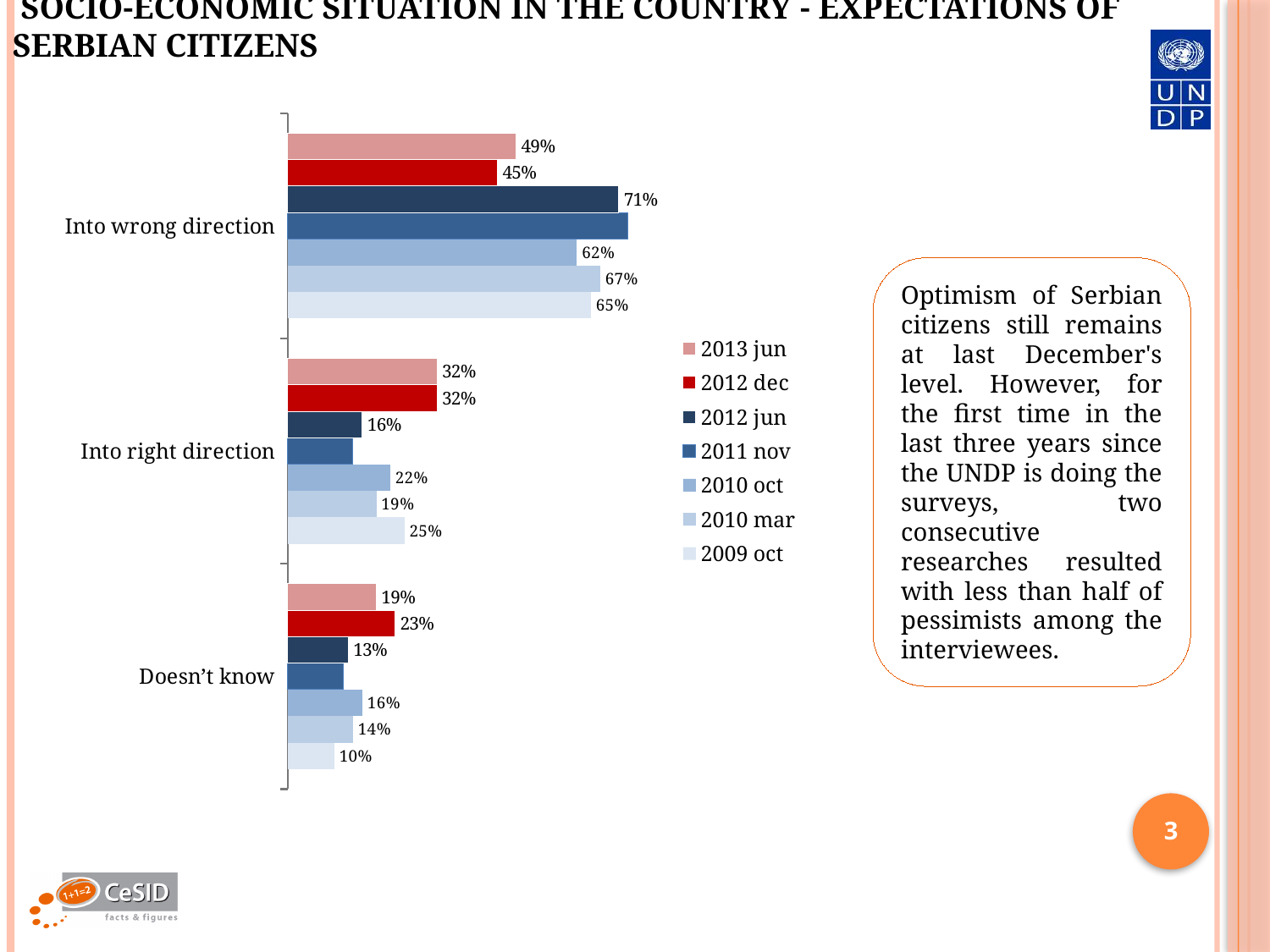
What is the value for 2009 oct in the 'Doesn't know' category? 10% In the 'Doesn't know' category, which is larger: the 2012 dec value or the 2013 jun value? 2012 dec What is the value for 2010 mar in the 'Into right direction' category? 19% How many series does the legend list? 7 In the 'Into right direction' category, which is larger: the 2010 oct value or the 2009 oct value? 2009 oct What is the value for 2013 jun in the 'Into wrong direction' category? 49% How many categories are shown on the chart? 3 Which survey wave has the lowest value in the 'Into wrong direction' category? 2012 dec What is the difference between the 2013 jun and 2012 dec values in the 'Into wrong direction' category? 4 percentage points What is the value for 2012 jun in the 'Into wrong direction' category? 71% What is the difference between the 2010 mar and 2009 oct values in the 'Into wrong direction' category? 2 percentage points What kind of chart is shown on the slide? Bar chart